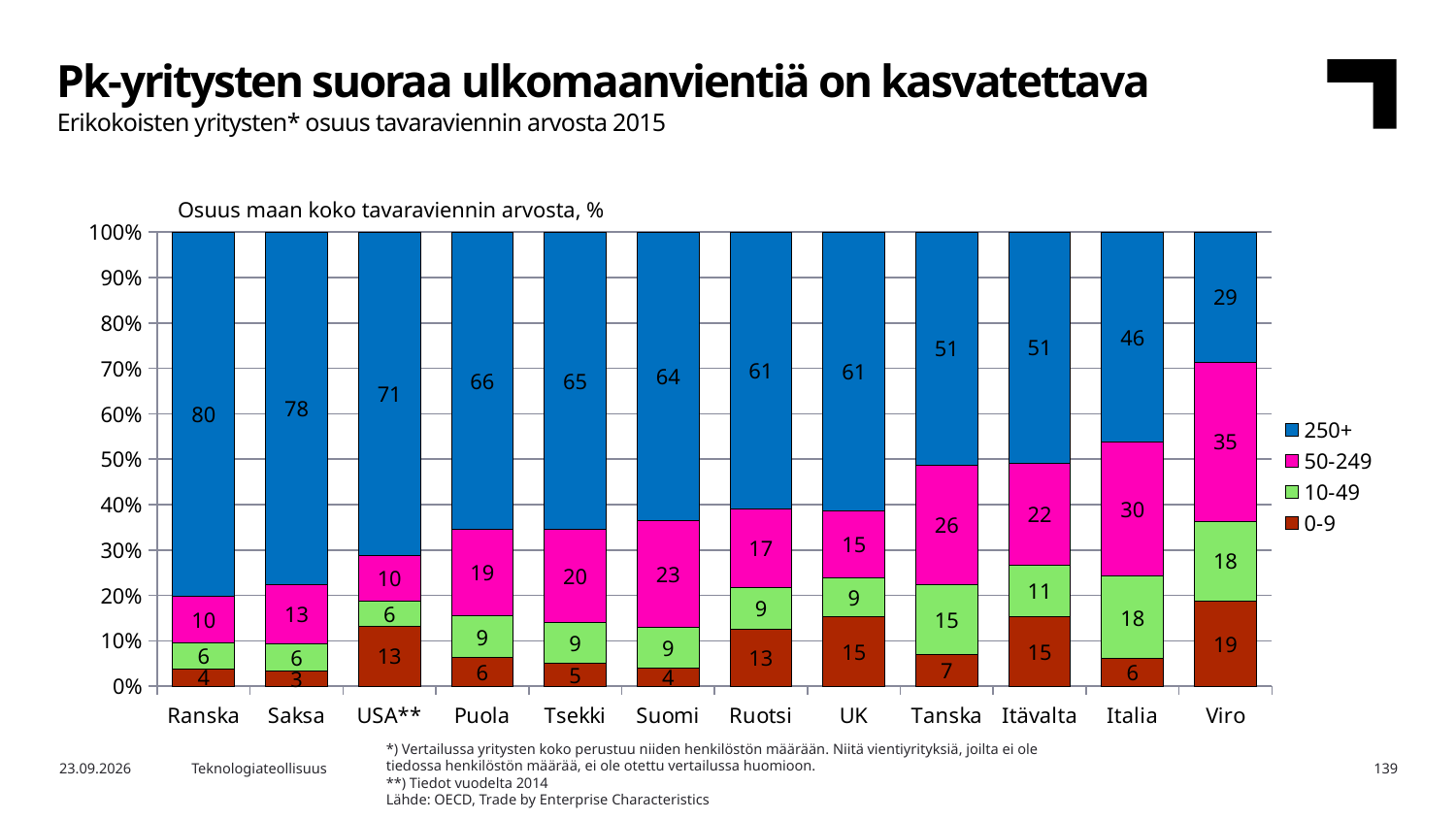
What is the difference between the 250+ values for Ranska and Viro? 51 What is the value of the 250+ series for Ranska? 80 What kind of chart is shown on the slide? Stacked bar chart What is the title printed above the chart's plot area? Osuus maan koko tavaraviennin arvosta, % What is the value of the 0-9 series for Viro? 19 How many countries are shown on the x axis? 12 What is the value of the 50-249 series for Suomi? 23 Which is larger, the 50-249 value for Italia or the 50-249 value for Tanska? Italia Which country has the lowest value for the 250+ series? Viro Does the 250+ series rise or fall from Ranska to Viro along the x axis? Fall How many series does the legend list? 4 Which country has the highest value for the 250+ series? Ranska